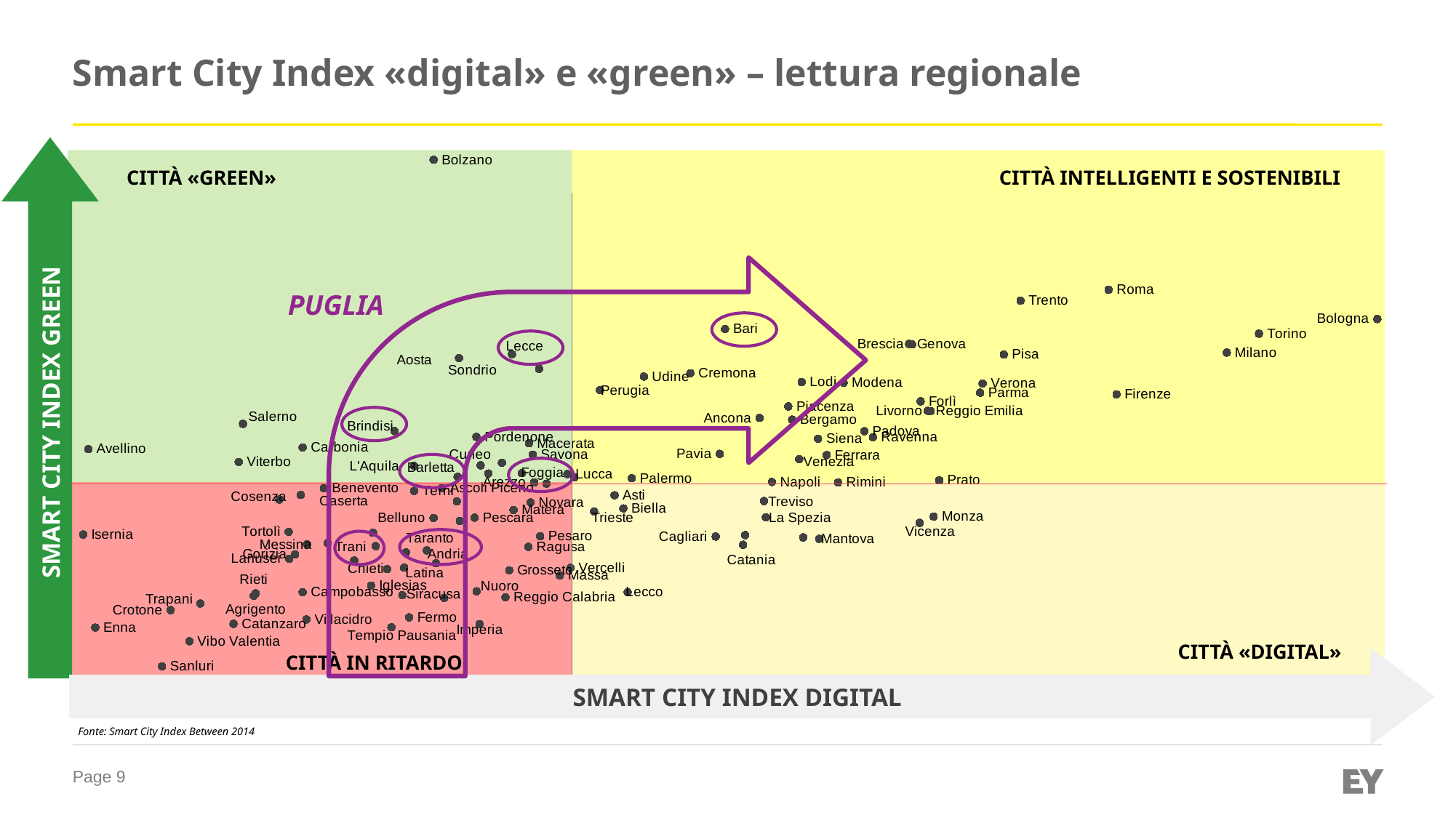
Which city is plotted furthest to the right on the Smart City Index Digital axis? Bologna Which city is plotted lowest on the Smart City Index Green axis? Sanluri Which city is plotted highest on the Smart City Index Green axis? Bolzano Which city is higher on the Smart City Index Green axis, Roma or Firenze? Roma Which region is highlighted by name on the chart? Puglia In which quadrant is Trani plotted? Città in ritardo In which quadrant is Bari plotted? Città intelligenti e sostenibili What is the label of the horizontal axis? Smart City Index Digital How many cities are circled as belonging to Puglia? 8 What kind of chart is shown on the slide? scatter chart In which quadrant is Lecce plotted? Città «green» Which city is further to the right on the Smart City Index Digital axis, Bari or Trani? Bari